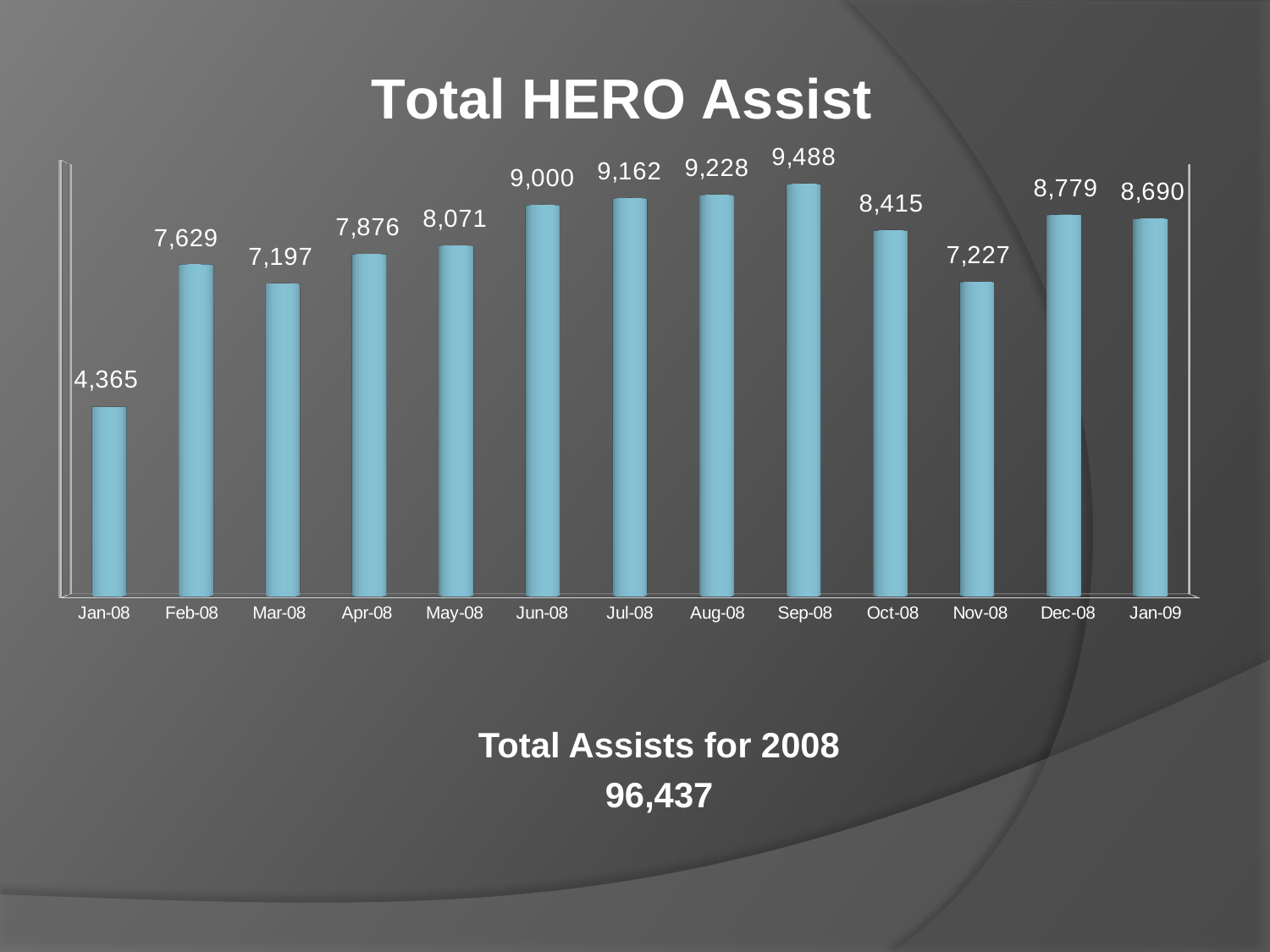
Which month has the highest value? Sep-08 What is the value for Sep-08? 9,488 What is the title of the chart? Total HERO Assist What is the value for Jan-08? 4,365 How many months are shown on the x axis? 13 Which is larger, the value for Feb-08 or the value for Mar-08? Feb-08 What kind of chart is this? Bar chart What is the value for Nov-08? 7,227 What is the value for Jan-09? 8,690 What is the difference between the values for Sep-08 and Jan-08? 5,123 What is the difference between the values for Dec-08 and Nov-08? 1,552 Which month has the lowest value? Jan-08